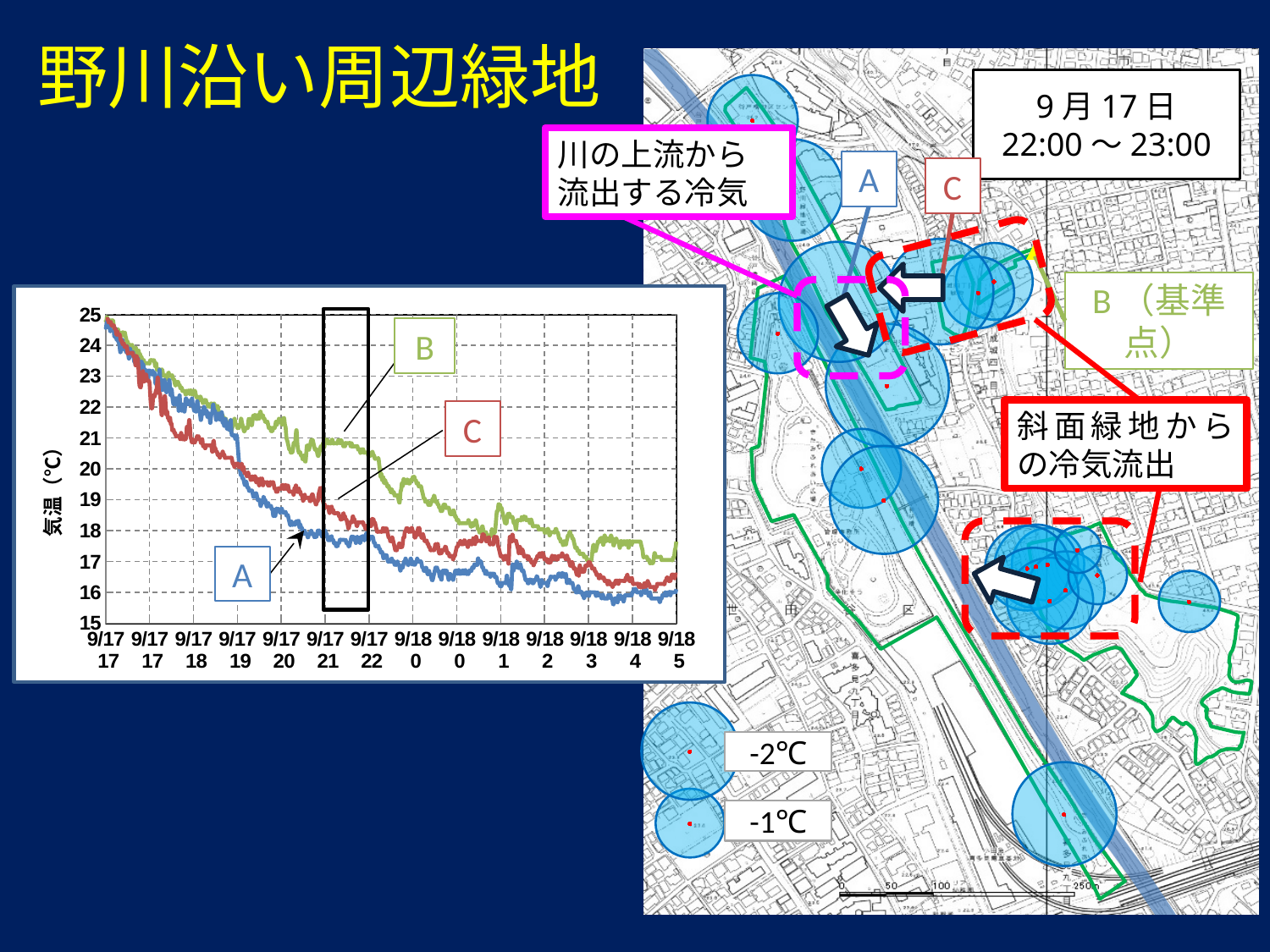
Which series has the highest temperature at 9/17 21 in the temperature chart? B What is the label of the y axis in the temperature chart? 気温 (℃) In the temperature chart, is the value for B at 9/17 21 greater or less than 20? greater In the temperature chart, which is larger at 9/18 2: the value for B or the value for A? B In the temperature chart, is the value for A at 9/17 21 greater or less than 19? less What colour is the line for series B in the temperature chart? green Which series has the lowest temperature at 9/18 5 in the temperature chart? A What kind of chart is shown on the left of the slide? line chart Do the temperatures in the chart rise or fall over time from 9/17 17 to 9/18 5? fall In the temperature chart, is the value for A at 9/18 5 greater or less than 17? less How many series are plotted in the temperature chart? 3